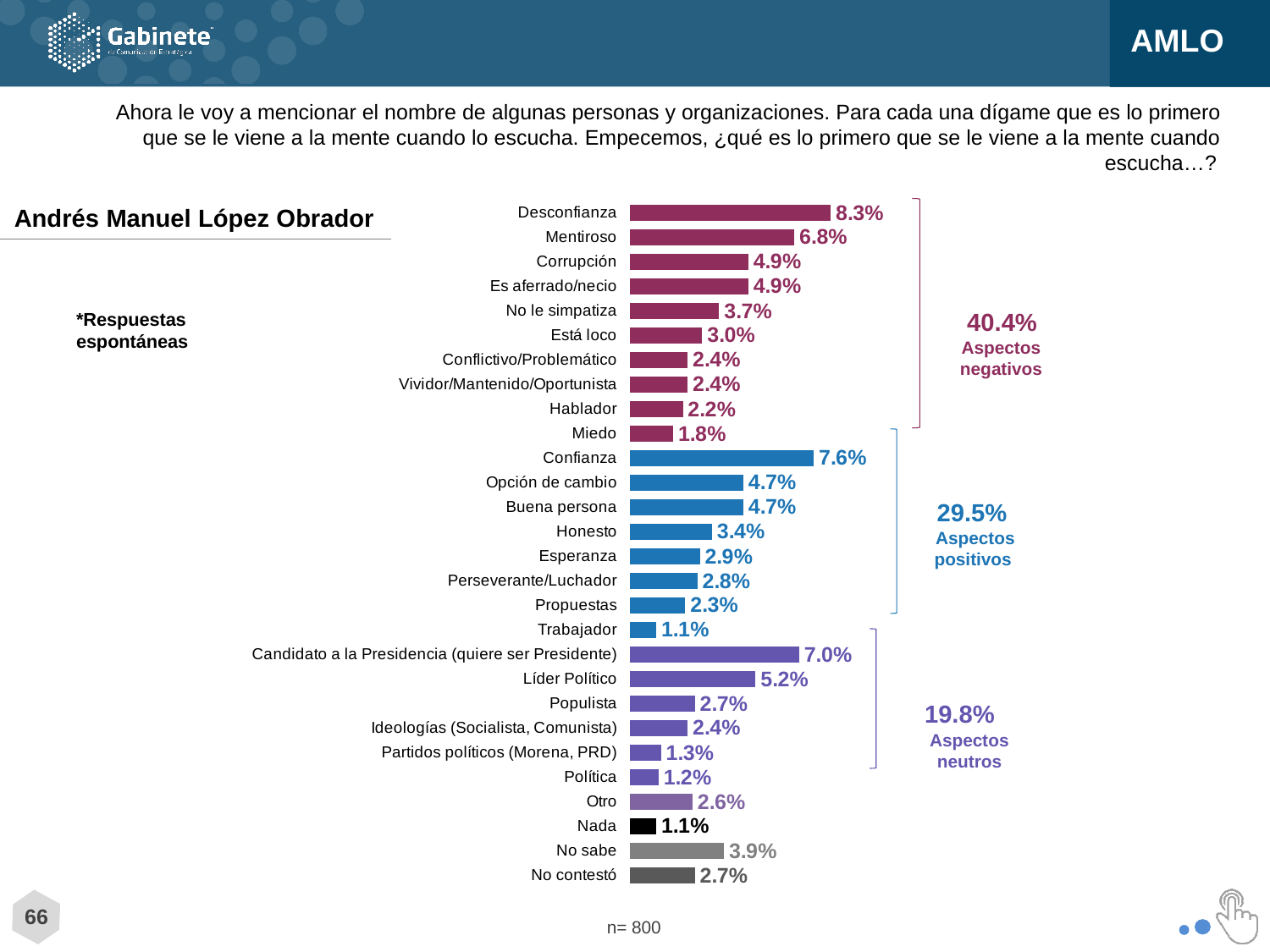
What is the difference between the values for Desconfianza and Mentiroso? 1.5% How many categories are plotted in the chart? 28 What total percentage is shown for the group labelled Aspectos negativos? 40.4% Which is larger, the value for Líder Político or the value for Populista? Líder Político What is the value for Candidato a la Presidencia (quiere ser Presidente)? 7.0% What is the value for Desconfianza? 8.3% Which is larger, the value for Mentiroso or the value for Confianza? Confianza What kind of chart is shown on the slide? bar chart What is the value for No sabe? 3.9% What is the value for Confianza? 7.6% What is the difference between the values for Confianza and Honesto? 4.2% Which category has the highest value in the chart? Desconfianza